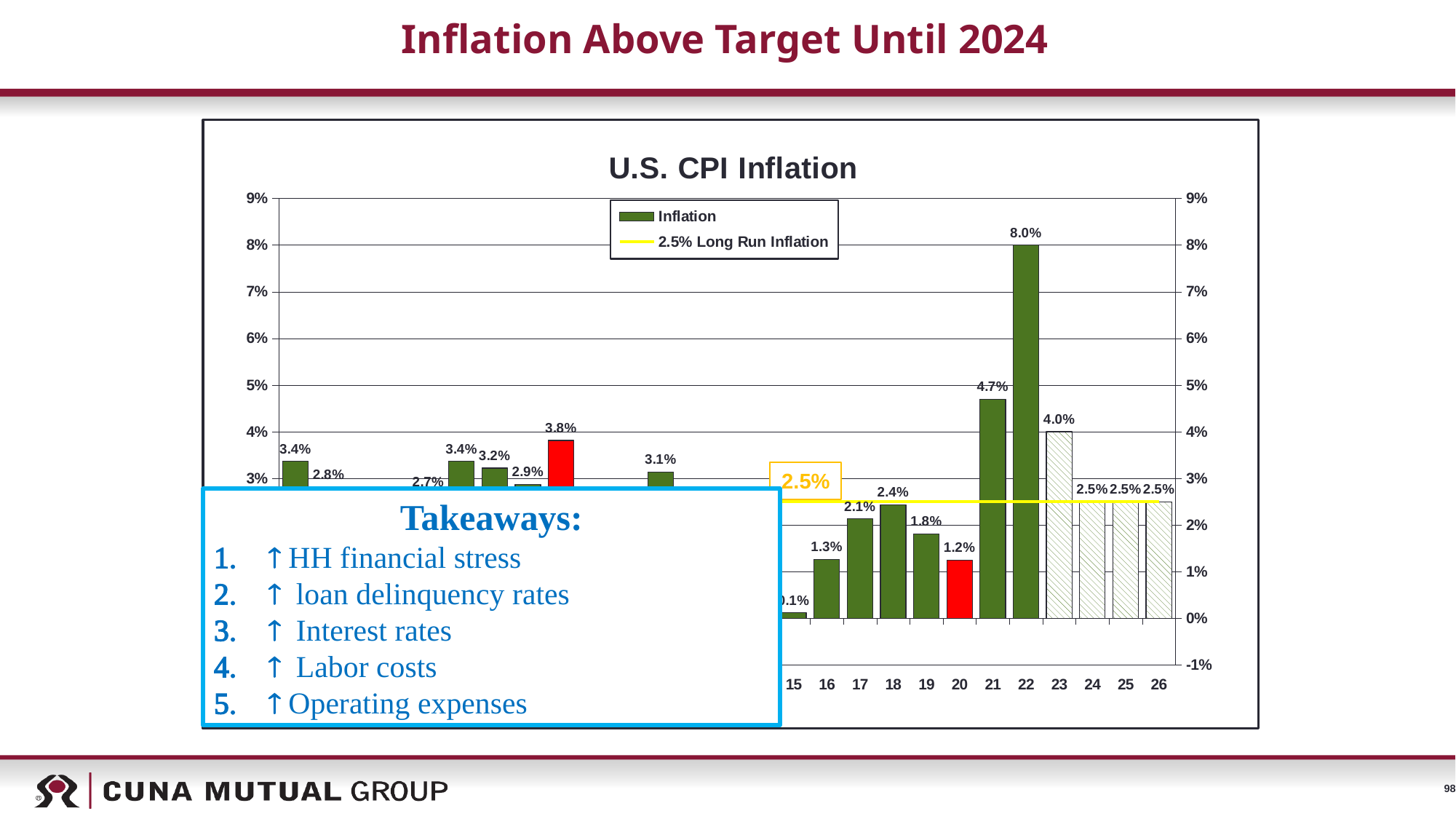
Which is larger, the inflation value for 18 or for 19? 18 Is the inflation value for 21 greater or less than 4%? greater What type of chart is used to show U.S. CPI Inflation? bar chart What inflation value is shown for each of 24, 25 and 26? 2.5% What is the title of the chart? U.S. CPI Inflation What is the difference between the inflation values for 22 and 21? 3.3% What is the inflation value shown for 23? 4.0% What is the inflation value shown for 16? 1.3% Which year has the highest inflation value on the chart? 22 What level does the yellow horizontal line in the chart represent? 2.5% Long Run Inflation How many entries does the chart legend list? 2 What is the inflation value shown for 22? 8.0%